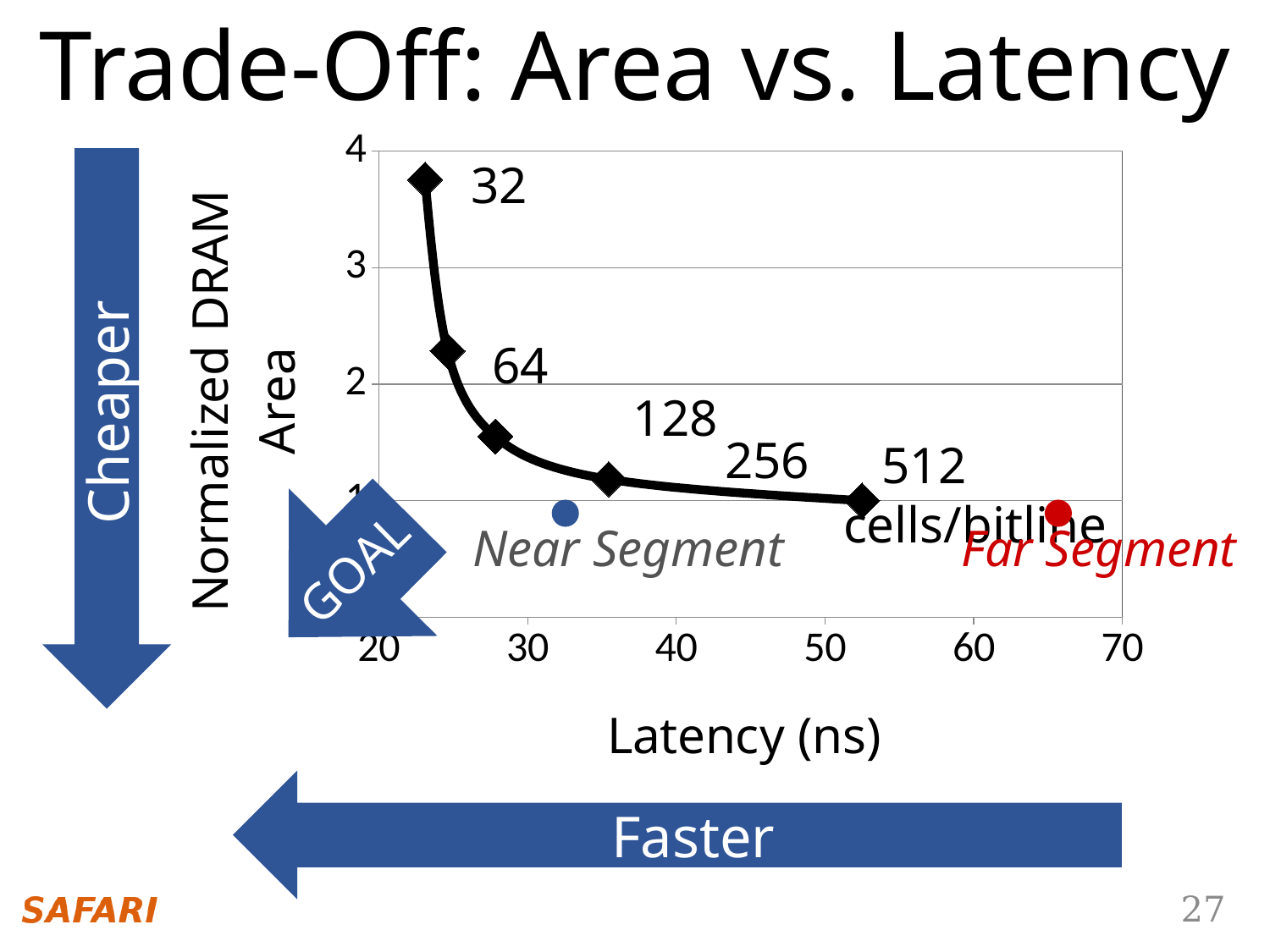
What is the title of the x axis? Latency (ns) Which cells/bitline point has the highest normalized DRAM area? 32 How many cells/bitline points are plotted on the curve? 5 Is the latency of the Far Segment point greater or less than 60 ns? greater Is the normalized DRAM area for 128 cells/bitline greater or less than 2? less As latency increases along the x axis, does the normalized DRAM area rise or fall? fall Is the normalized DRAM area for 32 cells/bitline greater or less than 3? greater What kind of chart is shown on the slide? Scatter chart with a line What is the title of the y axis? Normalized DRAM Area Which cells/bitline point has the lowest normalized DRAM area? 512 Which cells/bitline point has the highest latency? 512 Which has the larger normalized DRAM area, 64 cells/bitline or 128 cells/bitline? 64 cells/bitline